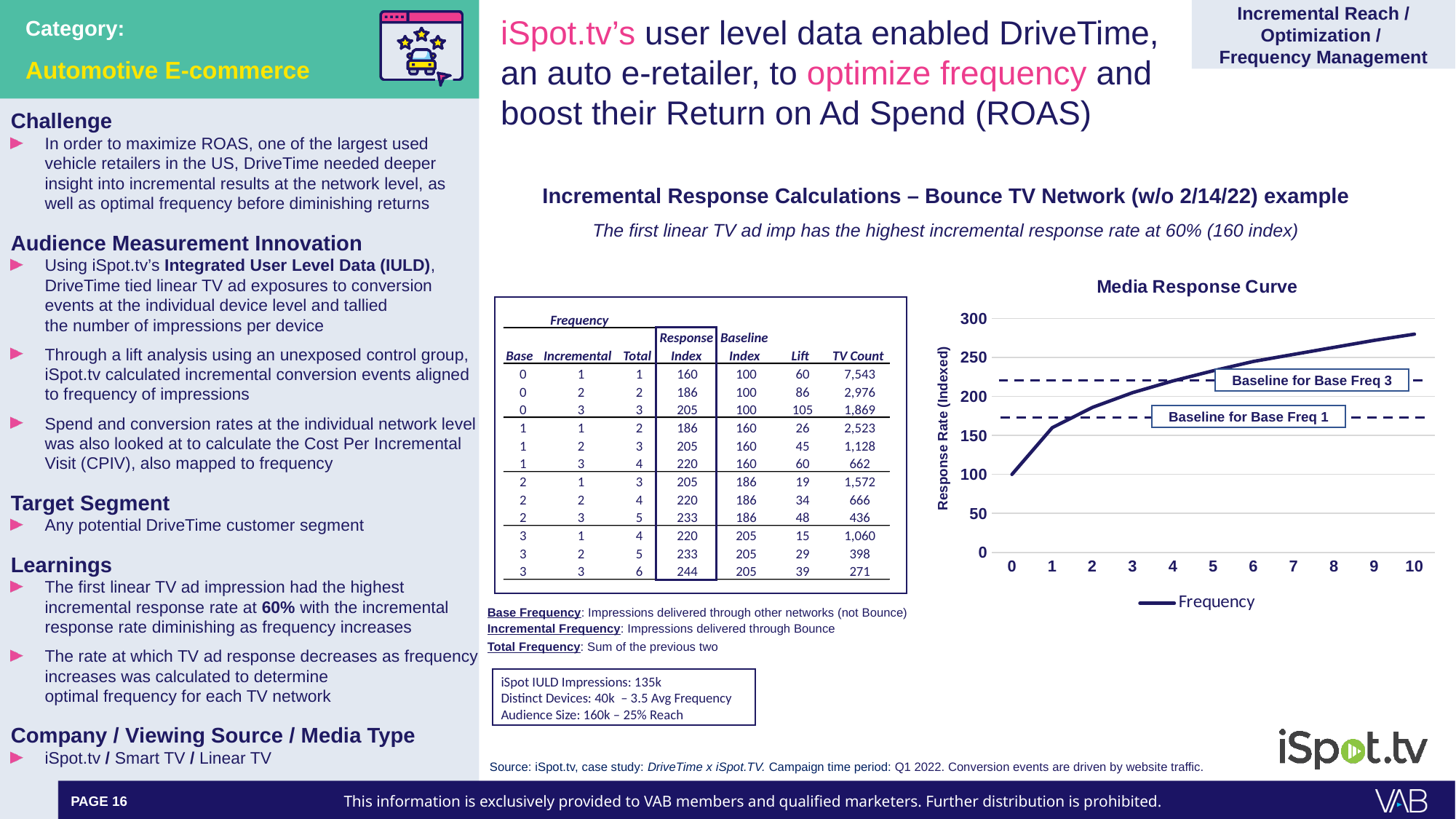
In the Media Response Curve, is the value at frequency 5 greater or less than 200? greater In the Media Response Curve, is the value at frequency 10 greater or less than 250? greater In the Media Response Curve, at which frequency is the response rate lowest? 0 In the Media Response Curve, which has the larger response rate: frequency 1 or frequency 10? frequency 10 In the Media Response Curve, does the response rate rise or fall as frequency increases from 0 to 10? rise What is the legend entry shown below the Media Response Curve chart? Frequency How many series does the legend of the Media Response Curve list? 1 What is the y-axis label of the Media Response Curve chart? Response Rate (Indexed) In the Media Response Curve, is the value at frequency 0 greater or less than 150? less What kind of chart is the Media Response Curve? line chart In the Media Response Curve, at which frequency is the response rate highest? 10